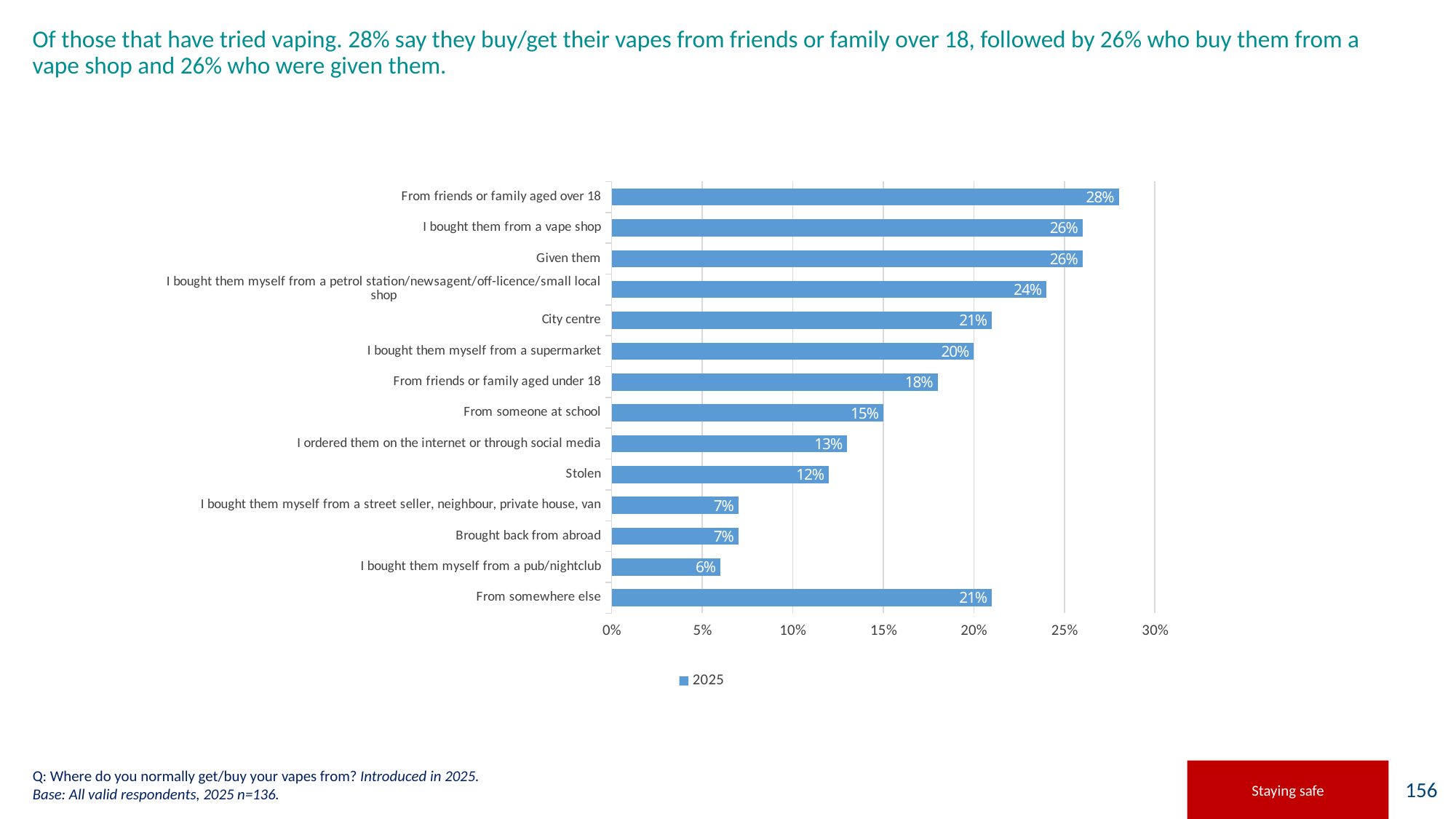
How many series does the legend list? 1 How many categories are shown in the chart? 14 Which is larger: 'City centre' or 'From someone at school'? City centre What is the value for 'I bought them myself from a supermarket'? 20% What percentage said 'Stolen'? 12% Is the value for 'I ordered them on the internet or through social media' greater or less than 15%? less What kind of chart is shown on the slide? Bar chart What year does the legend entry show? 2025 Which category has the highest value? From friends or family aged over 18 Which category has the lowest value? I bought them myself from a pub/nightclub What is the difference between 'From friends or family aged over 18' and 'From friends or family aged under 18'? 10% What percentage of respondents get their vapes from friends or family aged over 18? 28%